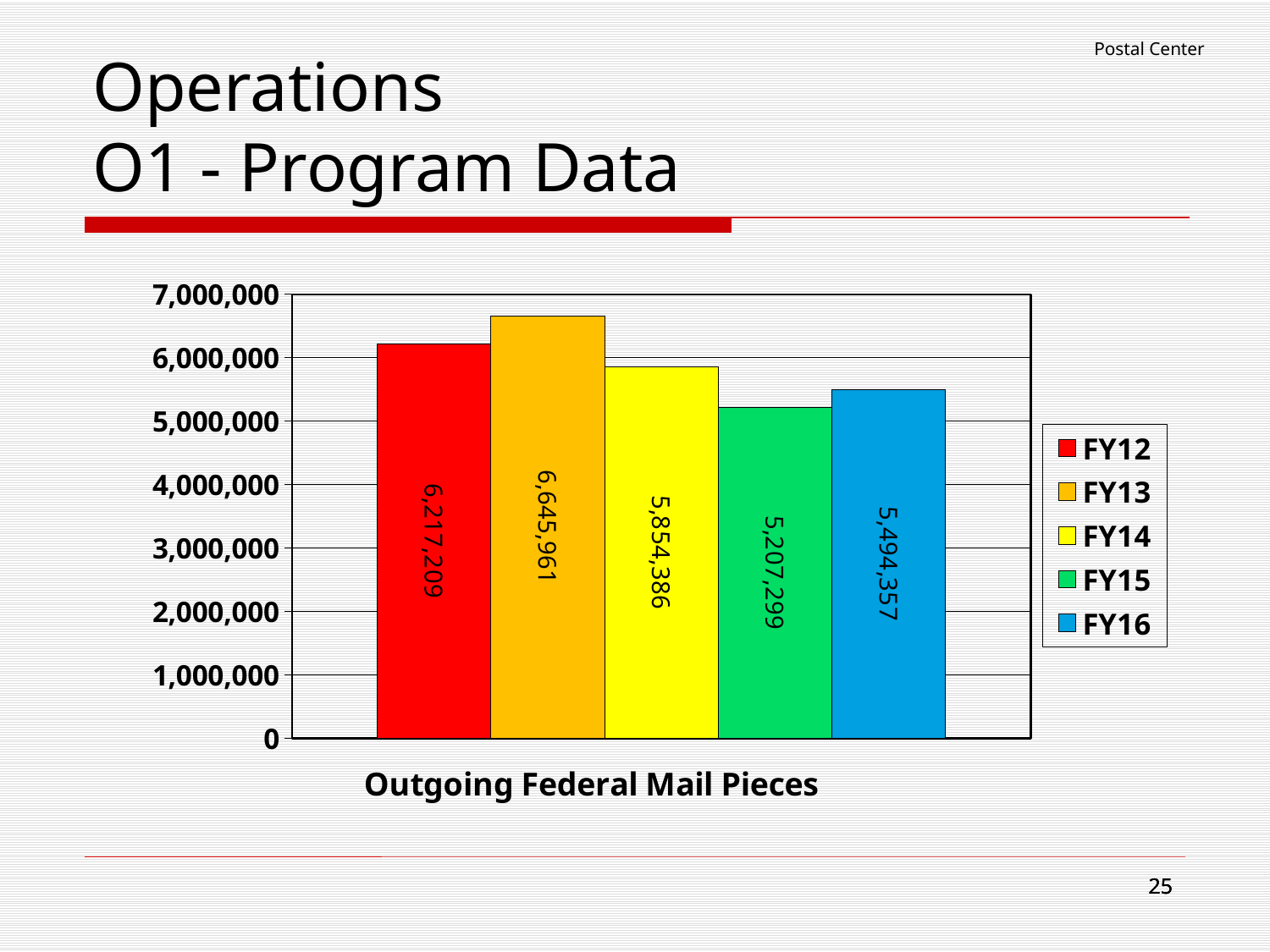
Which is larger, the value for FY14 or the value for FY16? FY14 How many series does the legend list? 5 Is the value for FY13 greater or less than 6,000,000? greater Do the values rise or fall from FY13 to FY15? fall Which fiscal year has the lowest number of outgoing federal mail pieces? FY15 What is the value for FY16 in the Outgoing Federal Mail Pieces chart? 5,494,357 What kind of chart is shown on the slide? bar chart What is the value for FY15 in the Outgoing Federal Mail Pieces chart? 5,207,299 Which fiscal year has the highest number of outgoing federal mail pieces? FY13 What is the value for FY12 in the Outgoing Federal Mail Pieces chart? 6,217,209 What is the difference between the FY16 and FY15 values? 287,058 What is the difference between the FY13 and FY12 values? 428,752